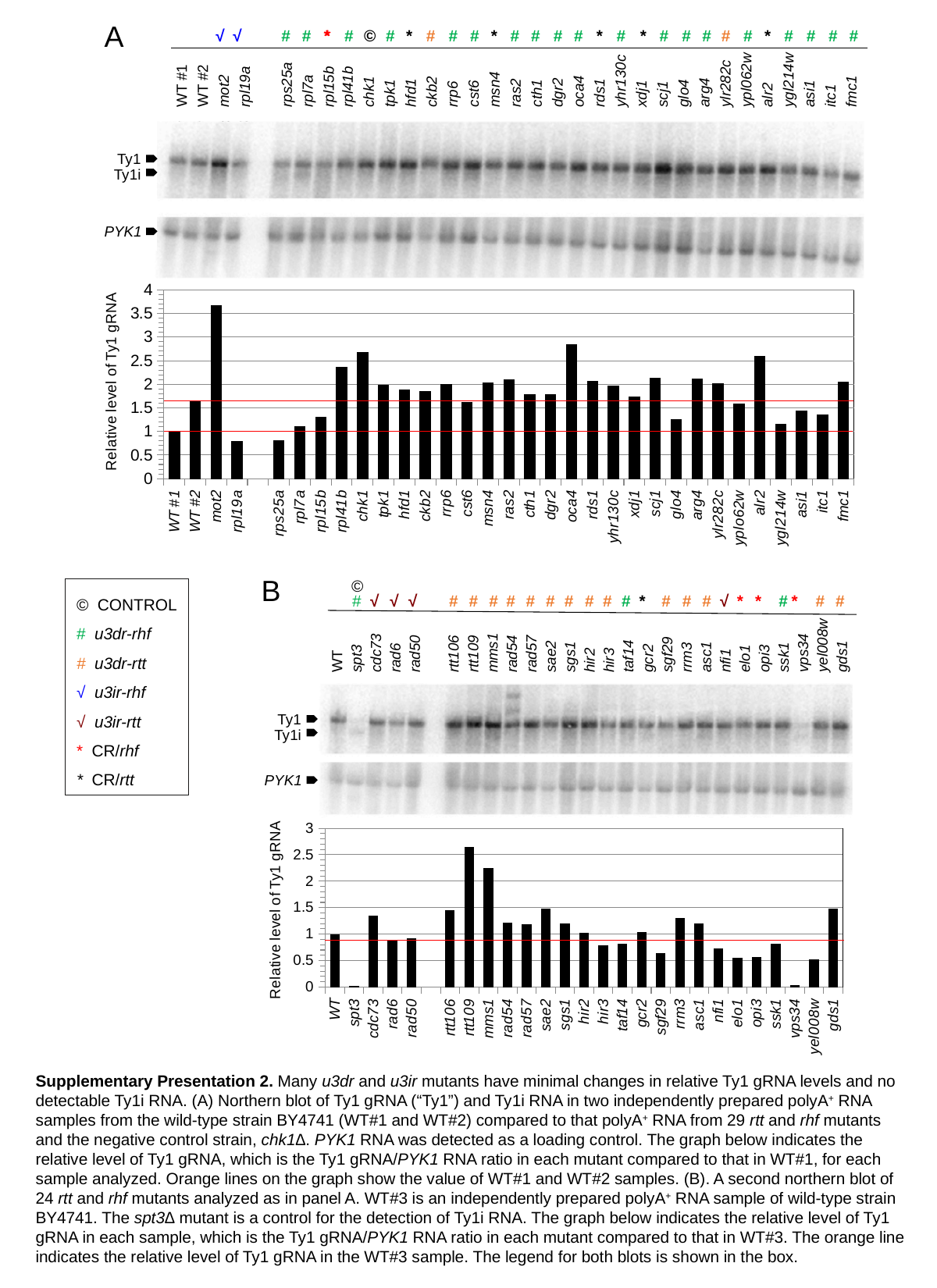
What is the y-axis title of the panel B chart? Relative level of Ty1 gRNA In the panel B chart, is the value for spt3 greater or less than 0.5? less In the panel B chart, which category has the highest relative level of Ty1 gRNA? rtt109 In the panel A chart, which is larger, the value for mot2 or the value for oca4? mot2 In the panel A chart, is the value for mot2 greater or less than 3? greater How many categories are plotted on the x axis of the panel A chart? 32 In the panel A chart, is the value for rpl19a greater or less than 1? less In the panel A chart, which category has the highest relative level of Ty1 gRNA? mot2 How many categories are plotted on the x axis of the panel B chart? 26 What kind of chart is shown in panel A? bar chart